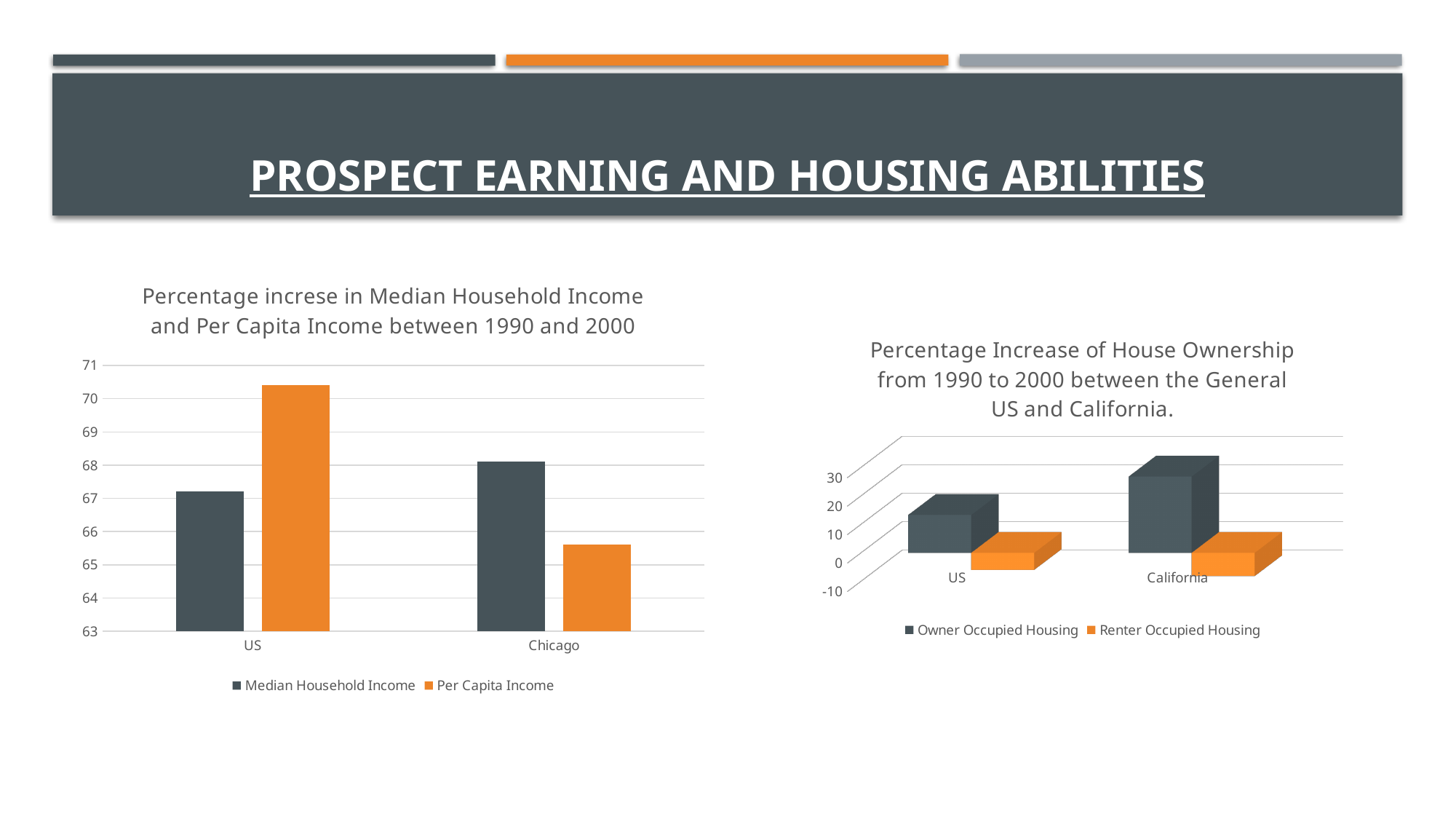
On the right chart, what are the two legend entries? Owner Occupied Housing and Renter Occupied Housing On the right chart, which category has the higher Owner Occupied Housing value: US or California? California On the right chart, how many series does the legend list? 2 On the left chart, is the Per Capita Income value for US greater or less than 70? greater On the right chart, is the Owner Occupied Housing value for California greater or less than 20? greater On the left chart, is the Per Capita Income value for Chicago greater or less than 66? less On the left chart, what kind of chart is shown? bar chart On the left chart, how many categories are shown on the x axis? 2 On the left chart, which is larger for US: Median Household Income or Per Capita Income? Per Capita Income On the left chart, how many series does the legend list? 2 On the left chart, which is larger for Chicago: Median Household Income or Per Capita Income? Median Household Income On the left chart, which bar is the tallest overall? Per Capita Income for US